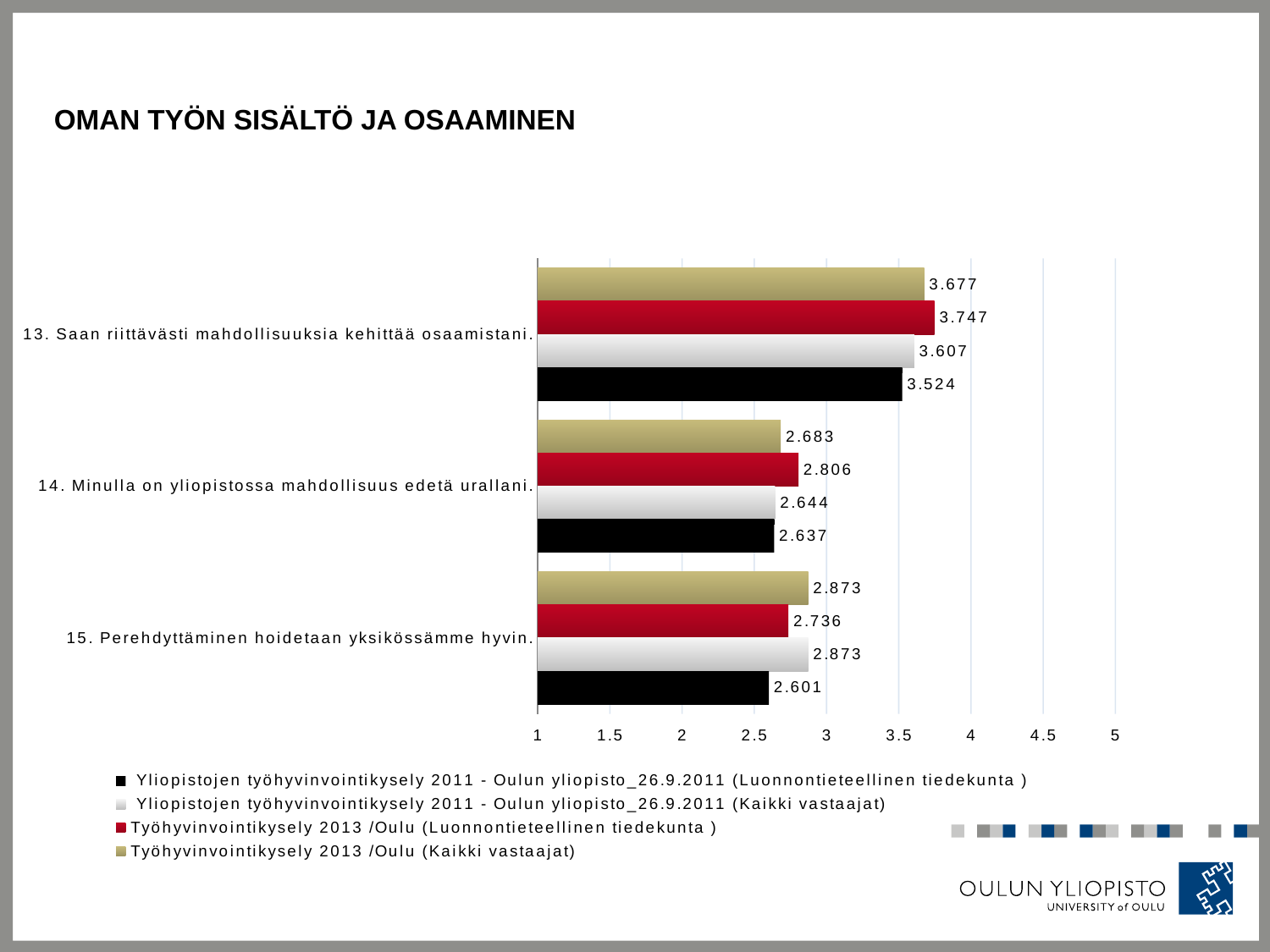
What is the value for '14. Minulla on yliopistossa mahdollisuus edetä urallani.' in the series 'Yliopistojen työhyvinvointikysely 2011 - Oulun yliopisto_26.9.2011 (Kaikki vastaajat)'? 2.644 How many series does the legend list? 4 For '15. Perehdyttäminen hoidetaan yksikössämme hyvin.', which is larger: the 'Työhyvinvointikysely 2013 /Oulu (Luonnontieteellinen tiedekunta )' value or the 'Työhyvinvointikysely 2013 /Oulu (Kaikki vastaajat)' value? Työhyvinvointikysely 2013 /Oulu (Kaikki vastaajat) What is the value for '13. Saan riittävästi mahdollisuuksia kehittää osaamistani.' in the series 'Työhyvinvointikysely 2013 /Oulu (Luonnontieteellinen tiedekunta )'? 3.747 What kind of chart is shown on the slide? Bar chart Which series has the lowest value for '13. Saan riittävästi mahdollisuuksia kehittää osaamistani.'? Yliopistojen työhyvinvointikysely 2011 - Oulun yliopisto_26.9.2011 (Luonnontieteellinen tiedekunta ) What is the value for '15. Perehdyttäminen hoidetaan yksikössämme hyvin.' in the series 'Työhyvinvointikysely 2013 /Oulu (Kaikki vastaajat)'? 2.873 Is the value for '13. Saan riittävästi mahdollisuuksia kehittää osaamistani.' in the series 'Työhyvinvointikysely 2013 /Oulu (Luonnontieteellinen tiedekunta )' greater or less than 3.5? greater Which category has the highest value in the series 'Työhyvinvointikysely 2013 /Oulu (Kaikki vastaajat)'? 13. Saan riittävästi mahdollisuuksia kehittää osaamistani. What is the difference between the 2013 and 2011 Luonnontieteellinen tiedekunta values for '14. Minulla on yliopistossa mahdollisuus edetä urallani.'? 0.169 What is the value for '15. Perehdyttäminen hoidetaan yksikössämme hyvin.' in the series 'Yliopistojen työhyvinvointikysely 2011 - Oulun yliopisto_26.9.2011 (Luonnontieteellinen tiedekunta )'? 2.601 How many categories are shown on the chart? 3